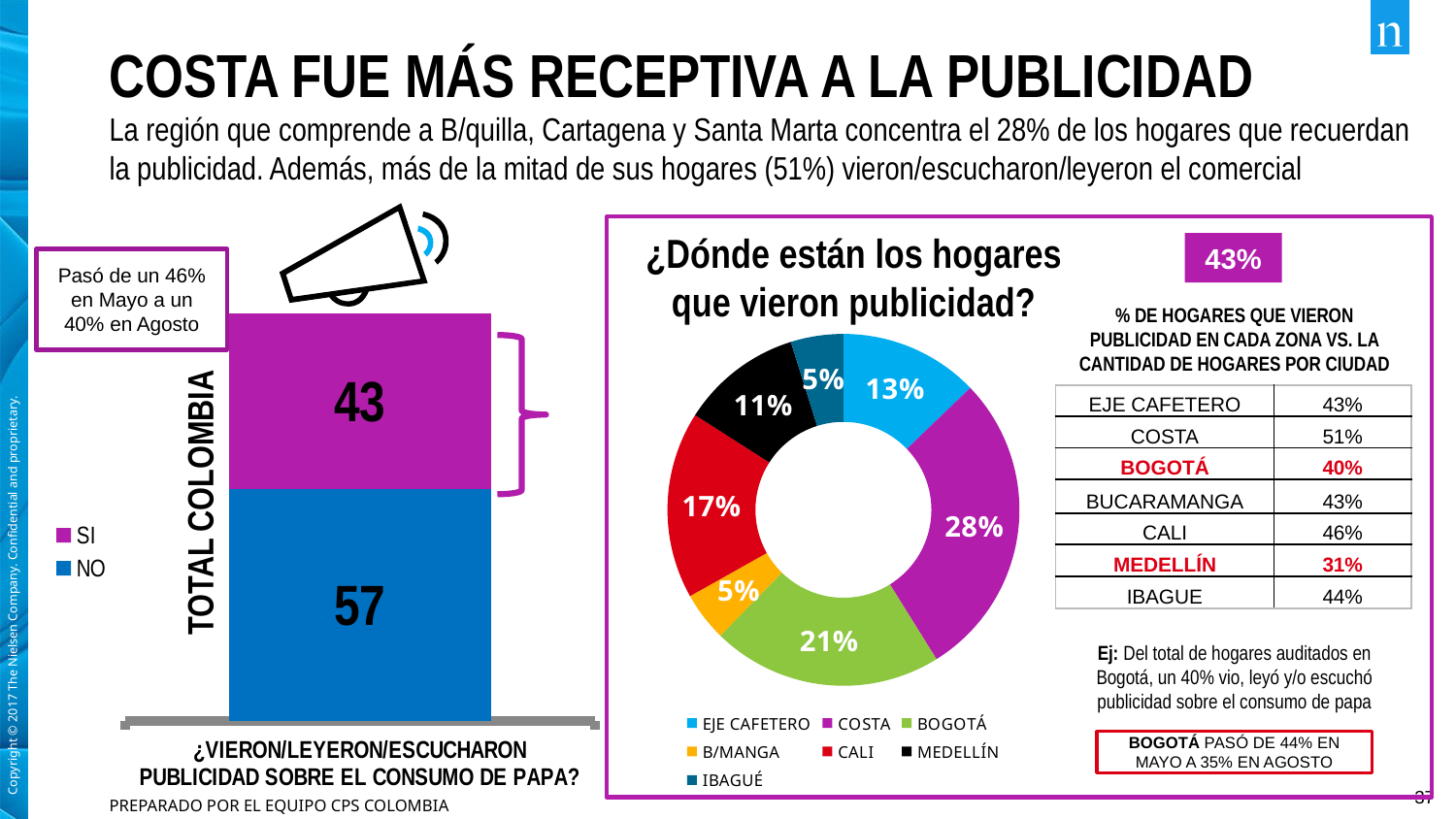
In the stacked bar chart on the left, what is the value for NO in TOTAL COLOMBIA? 57 What type of chart is the one on the left showing TOTAL COLOMBIA? Stacked bar chart In the donut chart '¿Dónde están los hogares que vieron publicidad?', which region has the largest share? COSTA In the stacked bar chart on the left, which is larger, SI or NO? NO In the donut chart '¿Dónde están los hogares que vieron publicidad?', what is the share for COSTA? 28% In the stacked bar chart on the left, how many series does the legend list? 2 In the stacked bar chart on the left, what is the value for SI in TOTAL COLOMBIA? 43 In the donut chart '¿Dónde están los hogares que vieron publicidad?', what is the share for CALI? 17% In the donut chart '¿Dónde están los hogares que vieron publicidad?', what is the difference between the shares of COSTA and BOGOTÁ? 7% In the donut chart '¿Dónde están los hogares que vieron publicidad?', how many regions are shown in the legend? 7 In the donut chart '¿Dónde están los hogares que vieron publicidad?', which is larger, EJE CAFETERO or MEDELLÍN? EJE CAFETERO In the stacked bar chart on the left, what is the total of the TOTAL COLOMBIA bar? 100